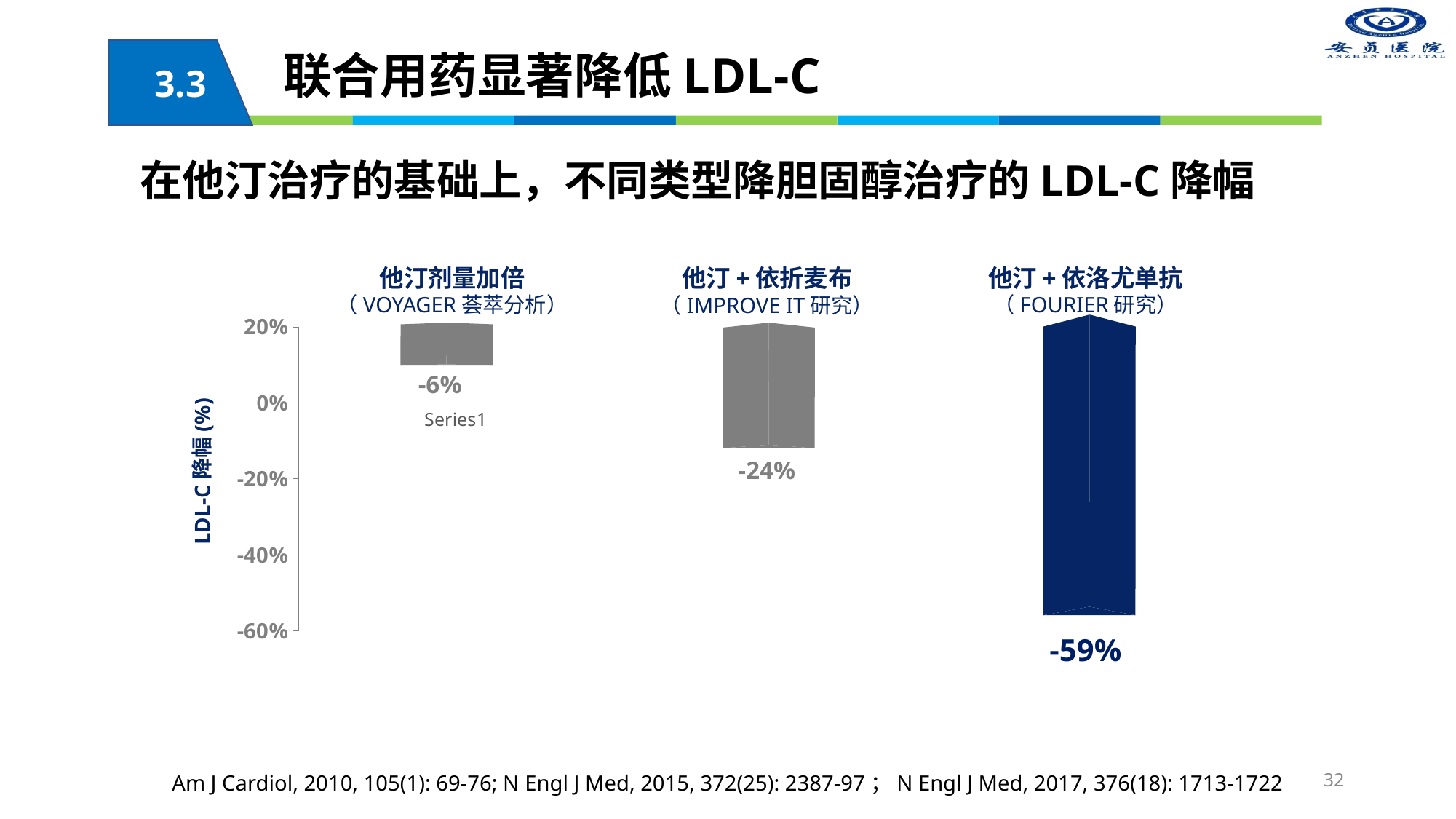
Which treatment shows the largest LDL-C reduction? 他汀 + 依洛尤单抗 (FOURIER 研究) What kind of chart is shown on the slide? Bar chart What is the LDL-C reduction shown for 他汀 + 依折麦布 (IMPROVE IT 研究)? -24% What is the difference in LDL-C reduction between 他汀 + 依洛尤单抗 and 他汀 + 依折麦布? 35% What is the LDL-C reduction shown for 他汀 + 依洛尤单抗 (FOURIER 研究)? -59% What is the difference in LDL-C reduction between 他汀 + 依折麦布 and 他汀剂量加倍? 18% What is the label of the vertical axis of the chart? LDL-C 降幅 (%) Which has a larger LDL-C reduction, 他汀 + 依折麦布 or 他汀剂量加倍? 他汀 + 依折麦布 What is the LDL-C reduction shown for 他汀剂量加倍 (VOYAGER 荟萃分析)? -6% How many treatment categories are shown in the chart? 3 What is the lowest tick value shown on the vertical axis? -60% Which treatment shows the smallest LDL-C reduction? 他汀剂量加倍 (VOYAGER 荟萃分析)